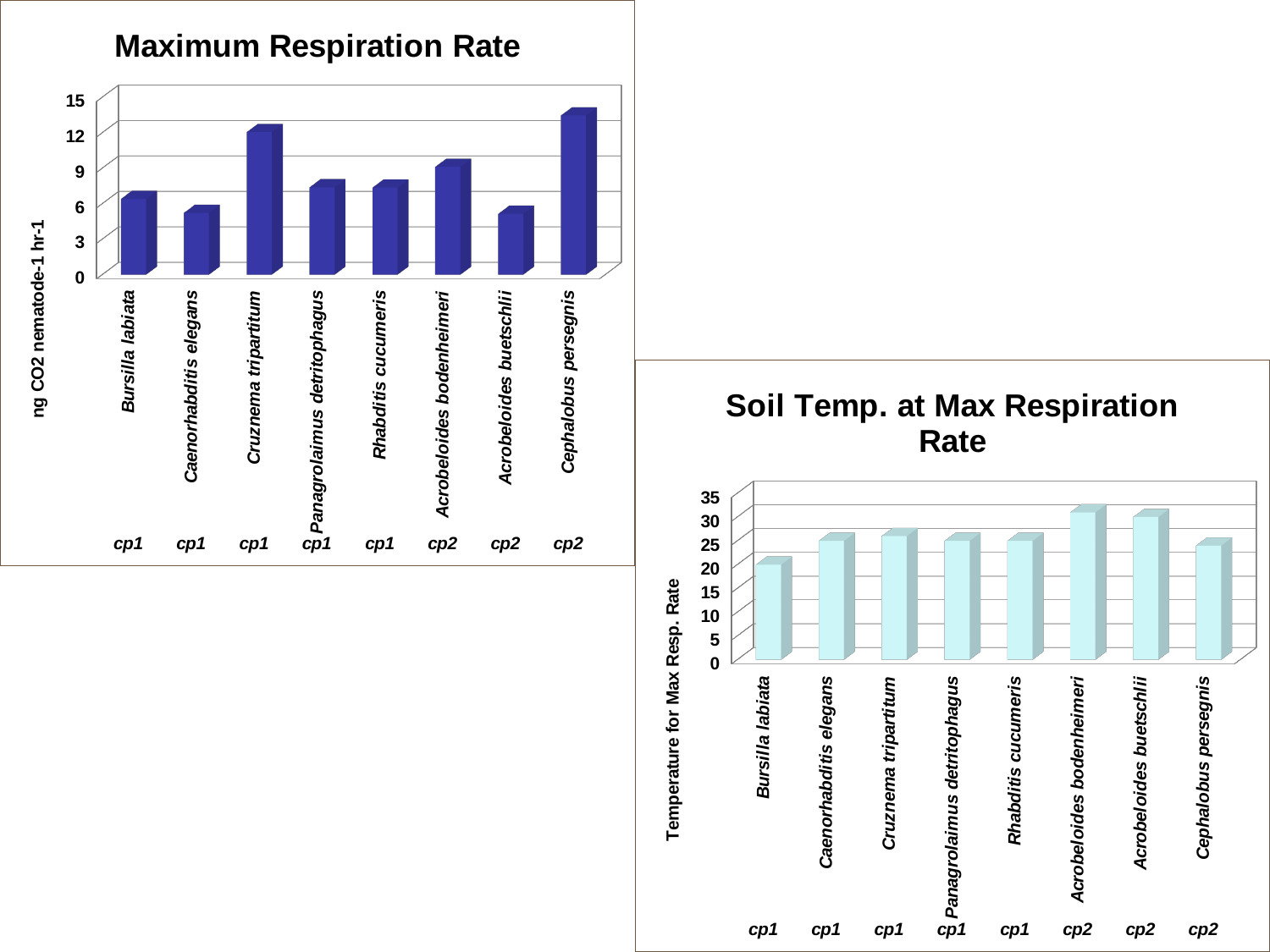
What is the y-axis label of the Maximum Respiration Rate chart? ng CO2 nematode-1 hr-1 How many species are plotted in the Maximum Respiration Rate chart? 8 In the Soil Temp. at Max Respiration Rate chart, is the value for Bursilla labiata greater or less than 25? less How many species are plotted in the Soil Temp. at Max Respiration Rate chart? 8 In the Maximum Respiration Rate chart, which is larger, the value for Cruznema tripartitum or for Acrobeloides bodenheimeri? Cruznema tripartitum In the Soil Temp. at Max Respiration Rate chart, which is larger, the value for Acrobeloides bodenheimeri or for Bursilla labiata? Acrobeloides bodenheimeri In the Soil Temp. at Max Respiration Rate chart, which species has the lowest soil temperature? Bursilla labiata In the Soil Temp. at Max Respiration Rate chart, is the value for Acrobeloides bodenheimeri greater or less than 25? greater What kind of chart is the Maximum Respiration Rate chart? bar chart In the Maximum Respiration Rate chart, is the value for Bursilla labiata greater or less than 9? less In the Maximum Respiration Rate chart, which species has the highest maximum respiration rate? Cephalobus persegnis